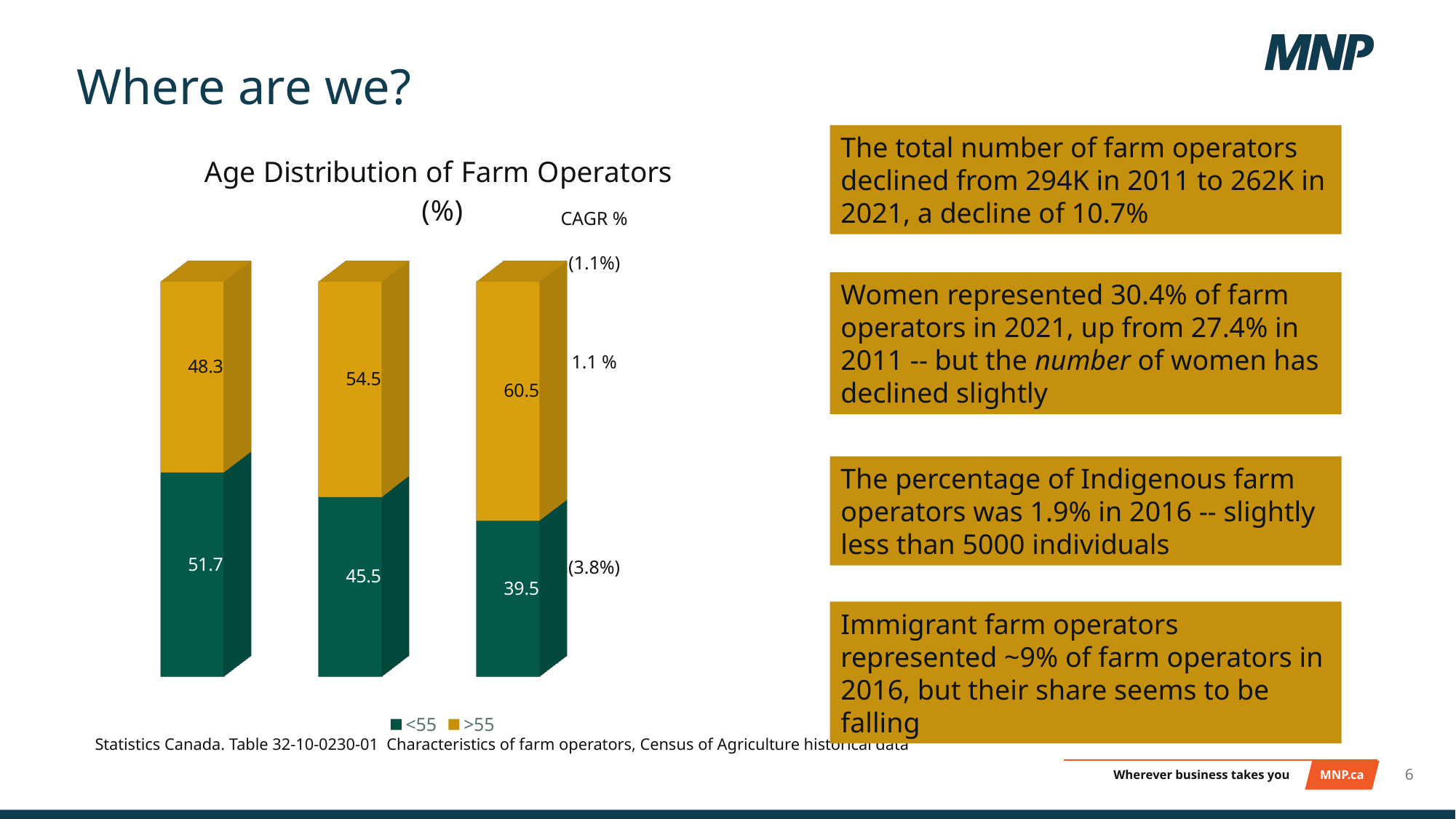
In the Age Distribution of Farm Operators chart, what is the difference between the >55 value in the rightmost bar and the >55 value in the leftmost bar? 12.2 In the Age Distribution of Farm Operators chart, what is the value of the >55 segment in the middle bar? 54.5 In the Age Distribution of Farm Operators chart, what is the value of the <55 segment in the leftmost bar? 51.7 In the Age Distribution of Farm Operators chart, does the <55 share rise or fall from the leftmost bar to the rightmost bar? Fall In the Age Distribution of Farm Operators chart, what CAGR % is shown next to the <55 segment of the rightmost bar? (3.8%) In the Age Distribution of Farm Operators chart, which bar has the lowest <55 value? The rightmost bar (39.5) In the Age Distribution of Farm Operators chart, what is the value of the >55 segment in the rightmost bar? 60.5 In the Age Distribution of Farm Operators chart, which bar has the highest >55 value? The rightmost bar (60.5) In the Age Distribution of Farm Operators chart, is the <55 value larger in the leftmost bar or the middle bar? The leftmost bar How many series does the legend of the Age Distribution of Farm Operators chart list? 2 How many bars are plotted in the Age Distribution of Farm Operators chart? 3 What type of chart is shown under the title "Age Distribution of Farm Operators (%)"? Stacked bar chart